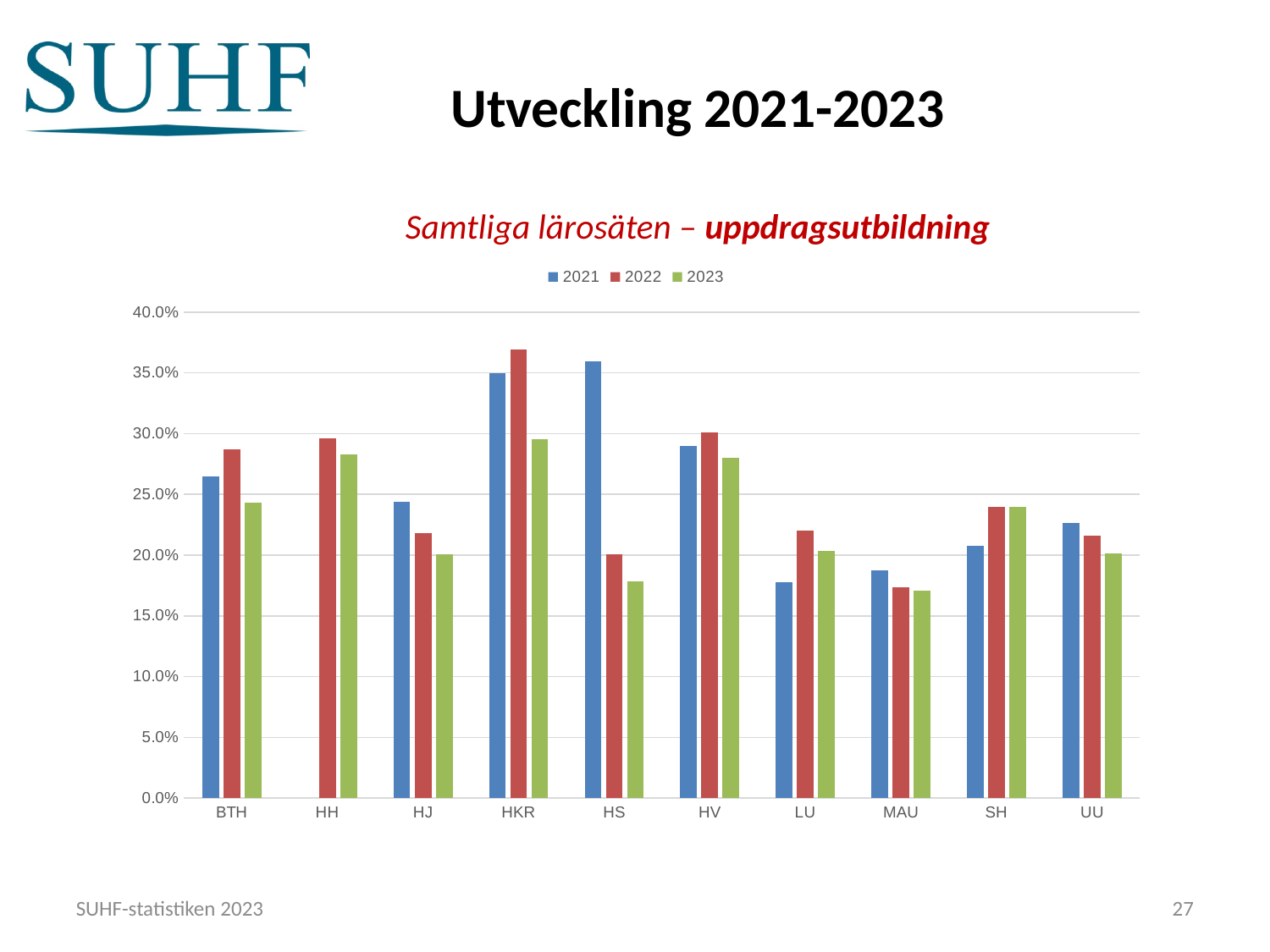
How many series does the legend list? 3 What kind of chart is shown on the slide? bar chart Which category has no bar for 2021? HH Do the values for HJ rise or fall from 2021 to 2023? fall How many categories (lärosäten) are shown on the x axis? 10 Is the 2021 value for BTH greater or less than 25.0%? greater Which category has the highest value for 2022? HKR Is the 2022 value for HKR greater or less than 35.0%? greater Is the 2023 value for HS greater or less than 20.0%? less Which is larger for HS: the 2021 value or the 2023 value? 2021 Which category has the lowest value for 2022? MAU